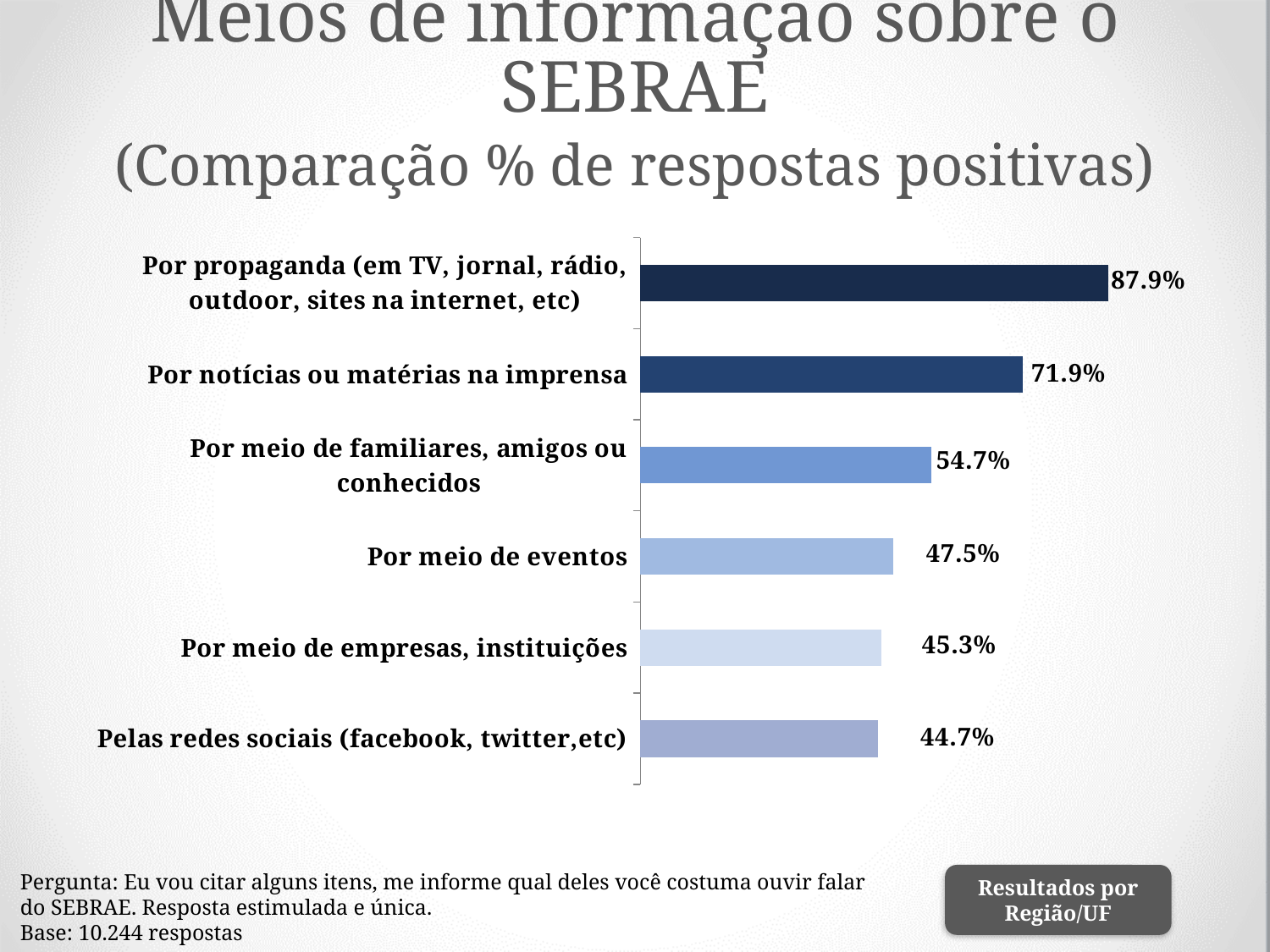
Which is larger: the value for "Por meio de familiares, amigos ou conhecidos" or for "Por meio de eventos"? Por meio de familiares, amigos ou conhecidos What is the difference between the values for "Por propaganda" and "Por notícias ou matérias na imprensa"? 16.0% Which category has the lowest value? Pelas redes sociais (facebook, twitter,etc) What is the value for "Por propaganda (em TV, jornal, rádio, outdoor, sites na internet, etc)"? 87.9% What is the value for "Por notícias ou matérias na imprensa"? 71.9% What is the value for "Por meio de familiares, amigos ou conhecidos"? 54.7% What is the difference between the values for "Por meio de eventos" and "Por meio de empresas, instituições"? 2.2% What kind of chart is shown on the slide? Bar chart What is the base (number of responses) stated on the slide? 10.244 respostas Which category has the highest value? Por propaganda (em TV, jornal, rádio, outdoor, sites na internet, etc) How many categories are shown in the chart? 6 What is the value for "Pelas redes sociais (facebook, twitter,etc)"? 44.7%